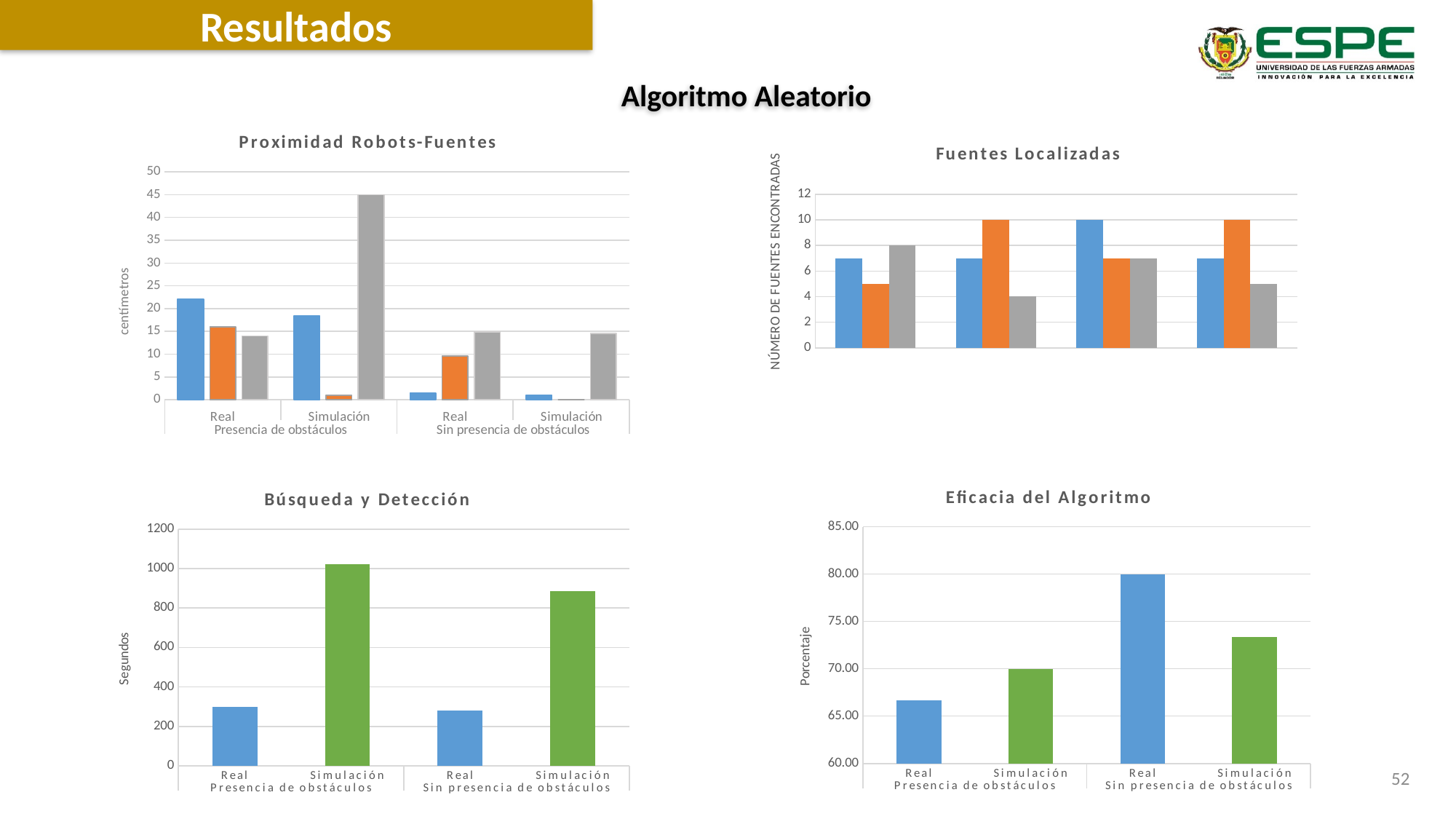
What is the y-axis label of the 'Fuentes Localizadas' chart? NÚMERO DE FUENTES ENCONTRADAS In the 'Fuentes Localizadas' chart, what is the highest value reached by any bar? 10 In the 'Búsqueda y Detección' chart, is the value for Simulación under Sin presencia de obstáculos greater or less than 800 segundos? greater What is the y-axis label of the 'Proximidad Robots-Fuentes' chart? centímetros In the 'Búsqueda y Detección' chart, which category has the highest value? Simulación, Presencia de obstáculos What kind of chart is the 'Proximidad Robots-Fuentes' chart? bar chart In the 'Proximidad Robots-Fuentes' chart, which bar group has the tallest bar? Simulación, Presencia de obstáculos In the 'Fuentes Localizadas' chart, how many groups of bars are plotted? 4 In the 'Búsqueda y Detección' chart, is the value for Real under Presencia de obstáculos greater or less than 400 segundos? less In the 'Eficacia del Algoritmo' chart, which category has the lowest percentage? Real, Presencia de obstáculos In the 'Proximidad Robots-Fuentes' chart, is the tallest gray bar (Simulación, Presencia de obstáculos) greater or less than 40 centímetros? greater